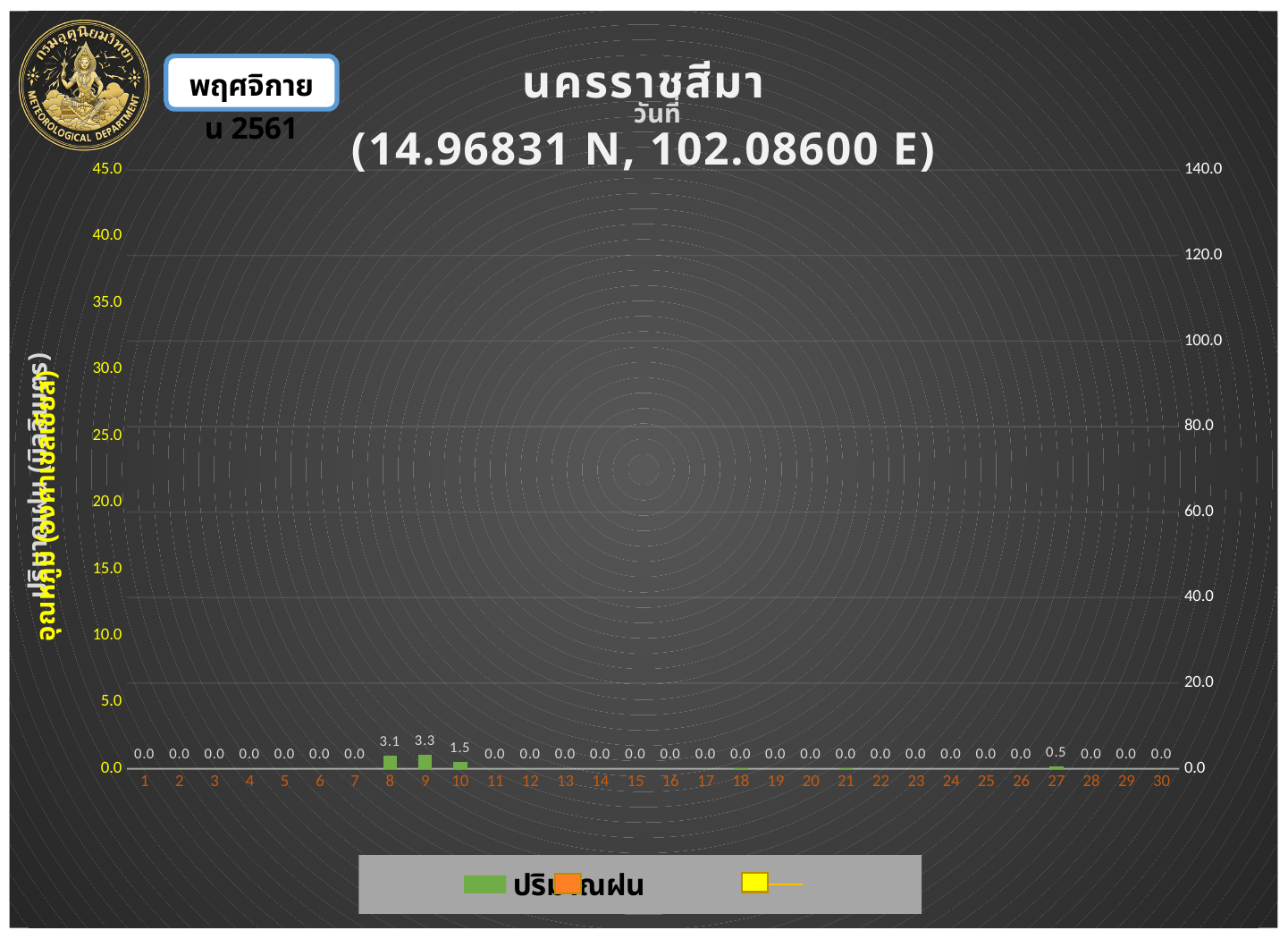
What is the rainfall value shown for day 10? 1.5 What is the rainfall value shown for day 27? 0.5 What is the difference between the rainfall values for day 8 and day 10? 1.6 Which is larger, the rainfall value for day 10 or for day 27? day 10 Which day has the highest rainfall value? 9 What is the difference between the rainfall values for day 9 and day 8? 0.2 What is the rainfall value shown for day 8? 3.1 What kind of chart is used to show the rainfall values? bar chart What is the rainfall value shown for day 9? 3.3 What is the rainfall value shown for day 15? 0.0 How many days are shown on the x axis? 30 What is the station name shown in the chart title? นครราชสีมา